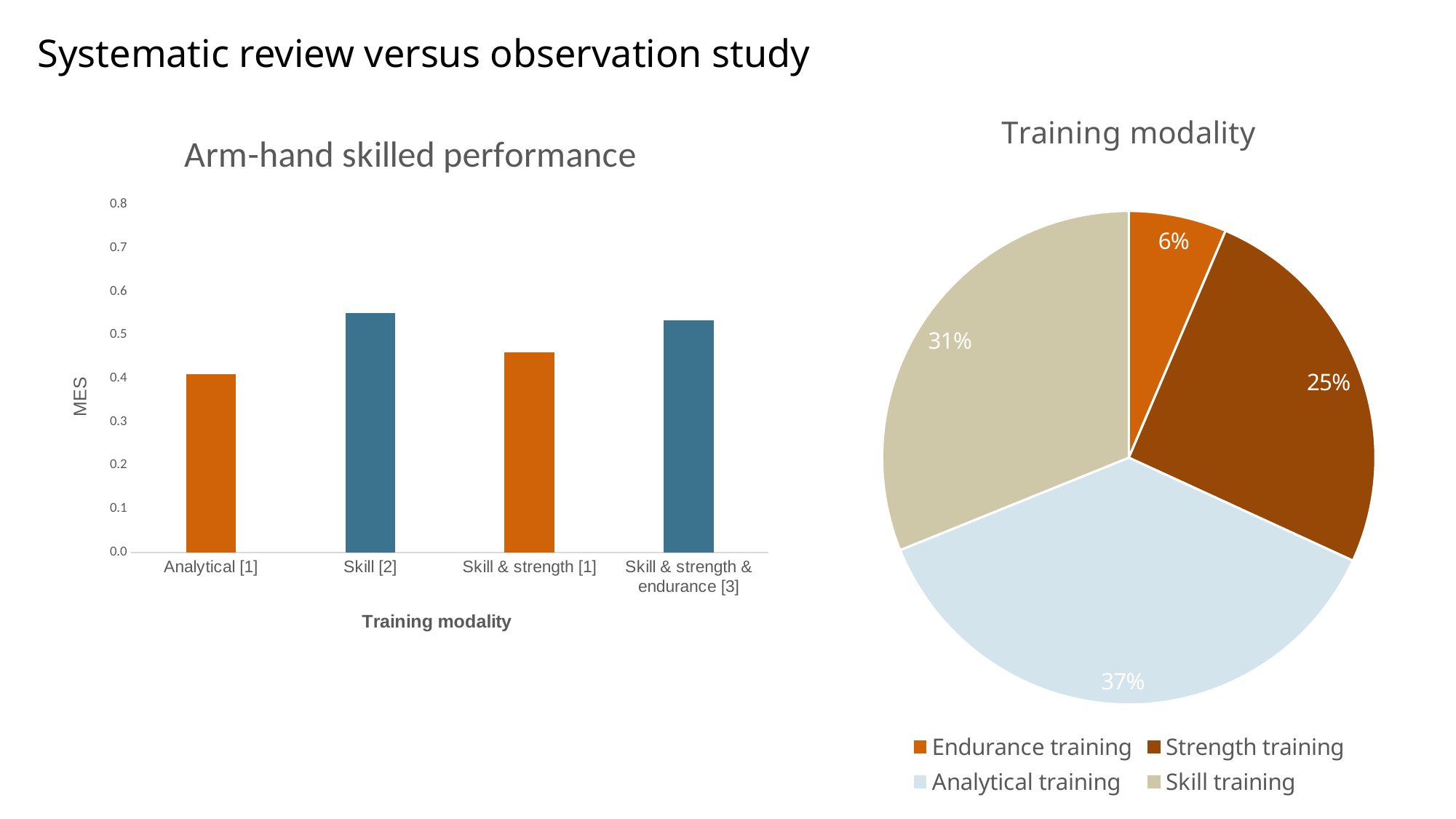
In the Training modality pie chart, what share does Skill training have? 31% In the Training modality pie chart, what share does Strength training have? 25% In the Arm-hand skilled performance chart, which is larger, the value for Skill [2] or the value for Analytical [1]? Skill [2] What kind of chart is the Arm-hand skilled performance chart? bar chart In the Training modality pie chart, what is the difference in percentage points between Analytical training and Endurance training? 31 In the Training modality pie chart, which training type has the largest share? Analytical training In the Training modality pie chart, which training type has the smallest share? Endurance training How many slices does the Training modality pie chart have? 4 What is the y-axis label of the Arm-hand skilled performance chart? MES In the Training modality pie chart, what share does Endurance training have? 6% In the Arm-hand skilled performance chart, is the value for Skill & strength [1] greater or less than 0.5? less In the Arm-hand skilled performance chart, is the value for Skill [2] greater or less than 0.5? greater